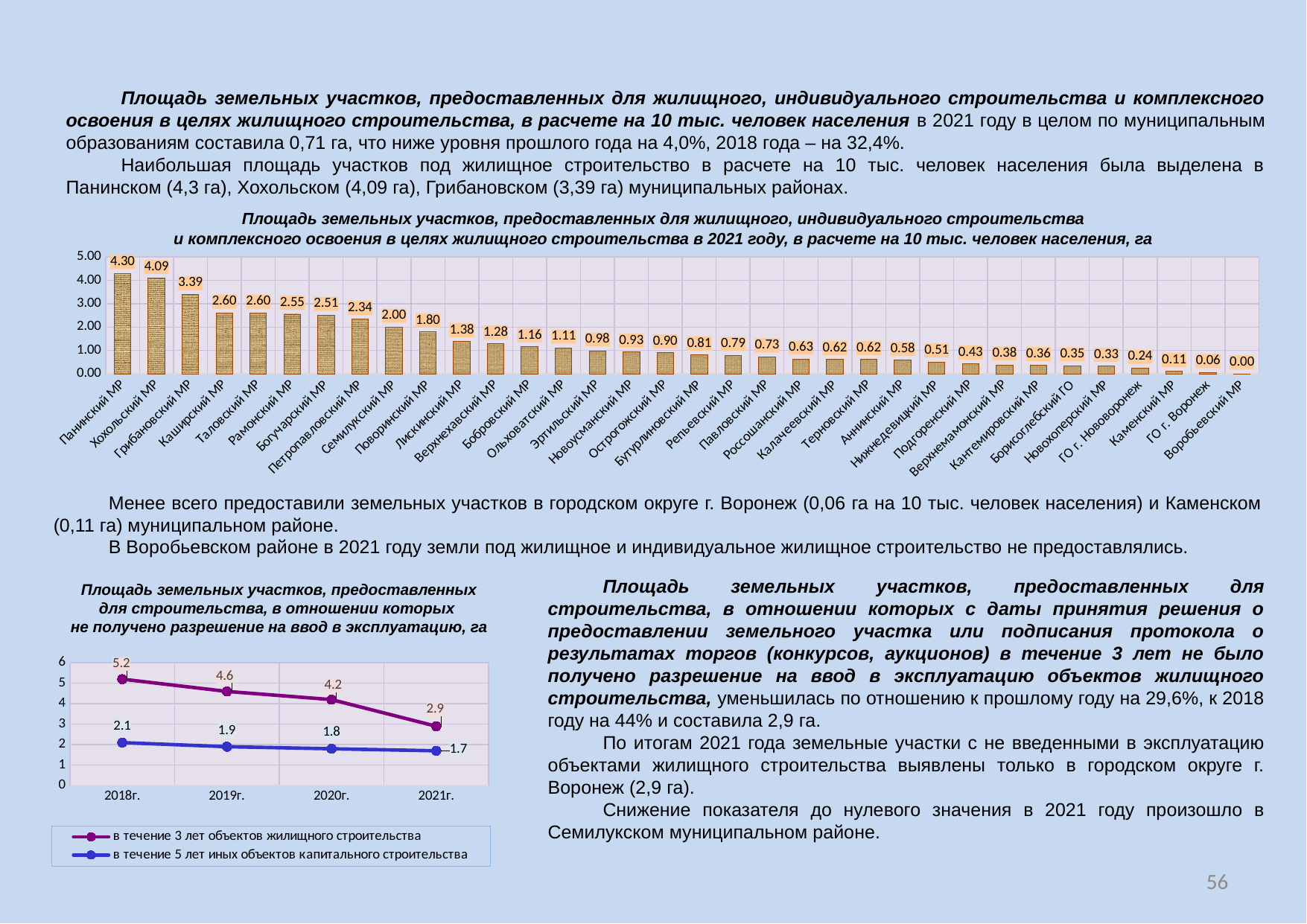
In the top bar chart, how many categories are shown? 34 What kind of chart is the top chart on the slide? Bar chart In the top bar chart, which category has the highest value? Панинский МР In the top bar chart, what is the value for Семилукский МР? 2.00 In the top bar chart, which category has the lowest value? Воробьевский МР In the top bar chart, what is the value for Панинский МР? 4.30 In the bottom-left line chart, how many series does the legend list? 2 In the top bar chart, which is larger: the value for Лискинский МР or the value for Бобровский МР? Лискинский МР In the bottom-left line chart, what is the value for 2021г. for the series 'в течение 3 лет объектов жилищного строительства'? 2.9 In the bottom-left line chart, do the values of the series 'в течение 3 лет объектов жилищного строительства' rise or fall from 2018г. to 2021г.? Fall In the top bar chart, what is the difference between the values for Хохольский МР and Грибановский МР? 0.70 In the bottom-left line chart, what is the difference between the two series' values in 2018г.? 3.1